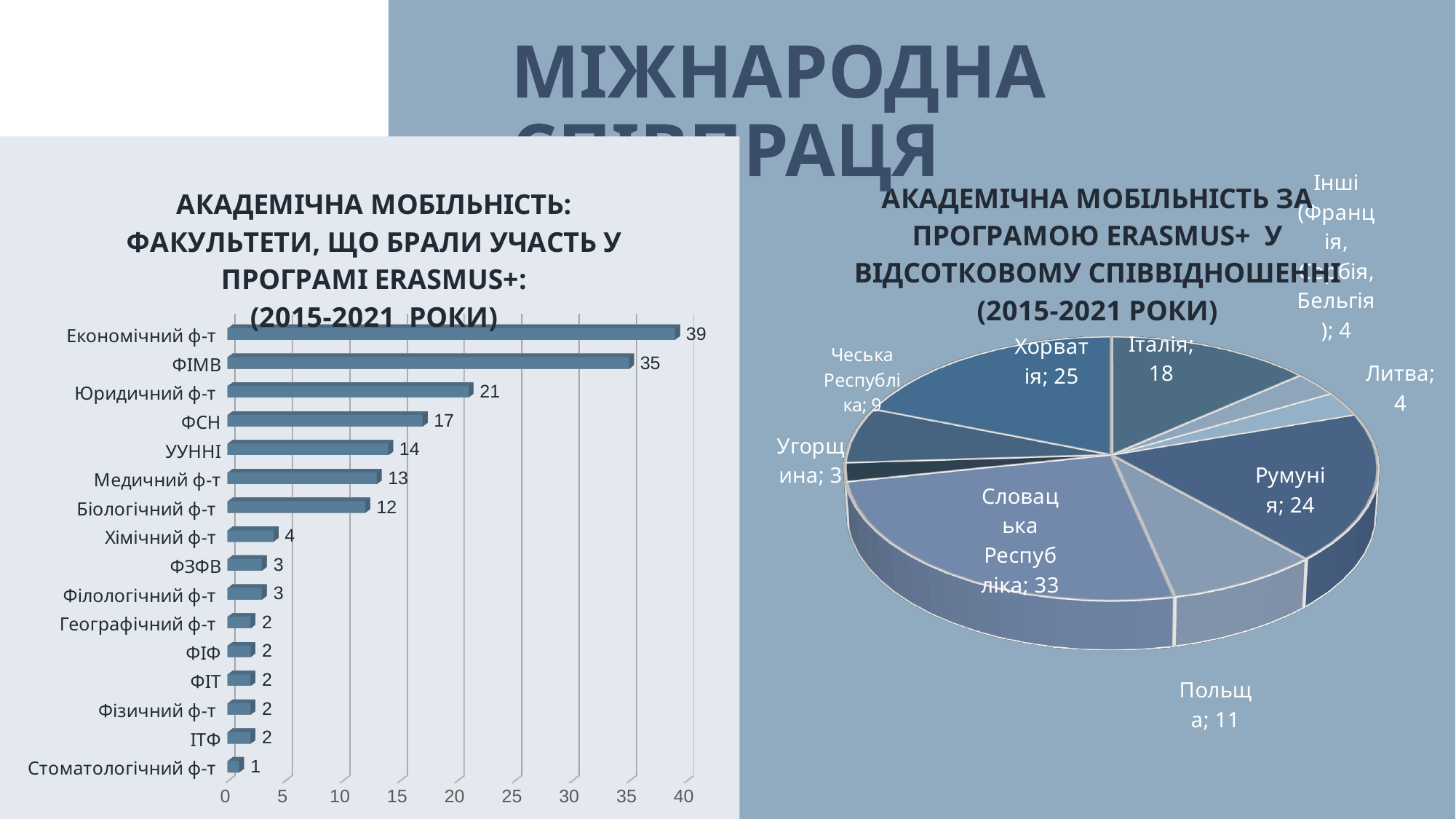
In the left bar chart, what is the value for Юридичний ф-т? 21 In the left bar chart, what is the difference between the values for Економічний ф-т and ФІМВ? 4 In the right pie chart, what is the value for Словацька Республіка? 33 How many slices does the right pie chart have? 9 In the left bar chart, which has a larger value: ФСН or УУННІ? ФСН In the left bar chart, which faculty has the lowest value? Стоматологічний ф-т In the right pie chart, which country has the largest value? Словацька Республіка In the right pie chart, what is the value for Польща? 11 In the right pie chart, what is the difference between the values for Хорватія and Румунія? 1 In the left bar chart, what is the value for Економічний ф-т? 39 What type of chart is the chart on the left side of the slide? bar chart How many faculties are shown in the left bar chart? 16